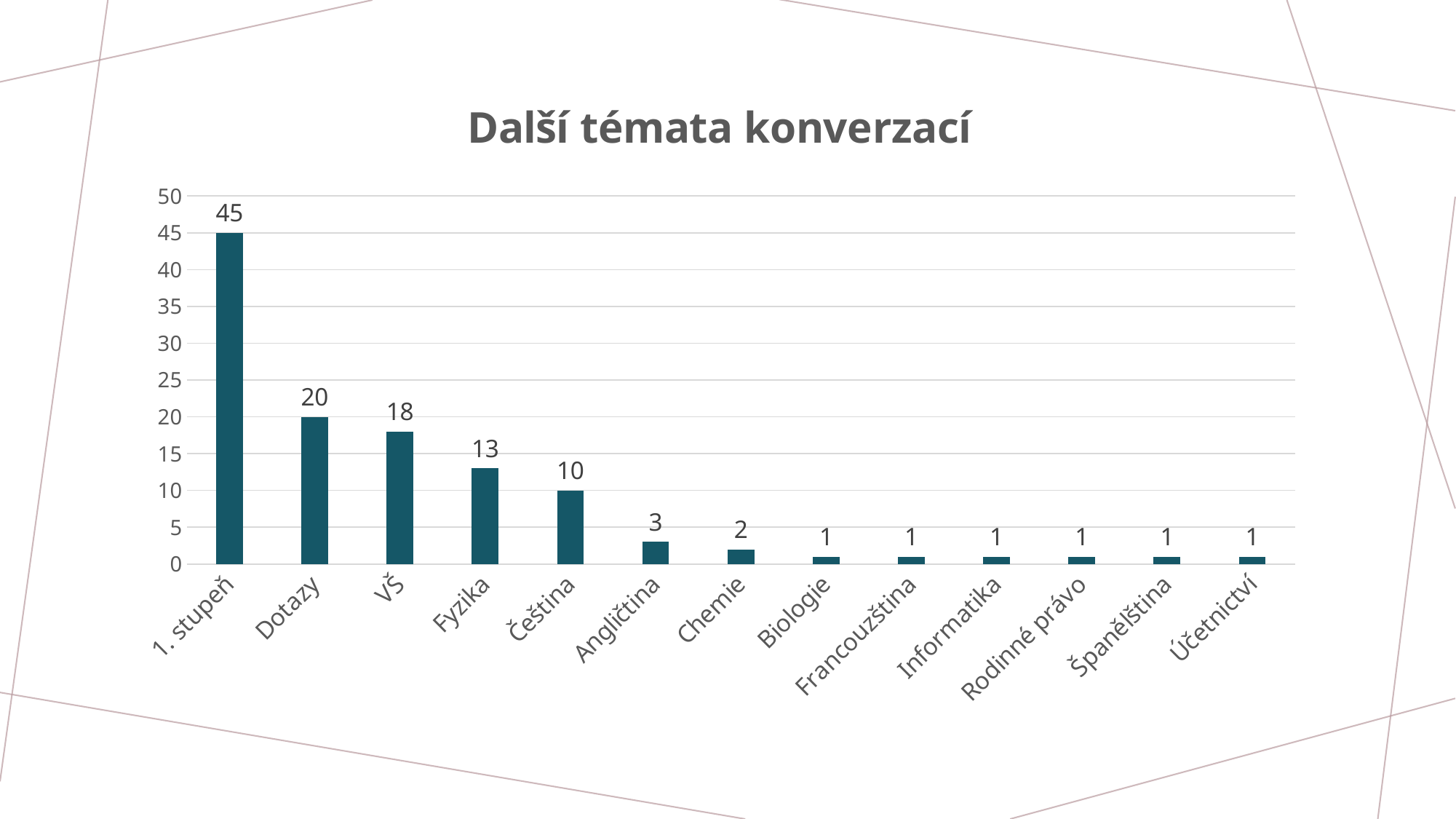
What is the value for Angličtina? 3 Is the value for Dotazy greater or less than 15? greater What is the value for Fyzika? 13 How many categories are shown on the x axis? 13 Which category has the highest value? 1. stupeň What is the value for 1. stupeň? 45 What is the title of the chart? Další témata konverzací Which is larger, the value for Fyzika or the value for Chemie? Fyzika Do the values rise or fall from left to right along the x axis? fall What is the difference between the values for Dotazy and VŠ? 2 What is the difference between the values for 1. stupeň and Čeština? 35 What kind of chart is shown? bar chart